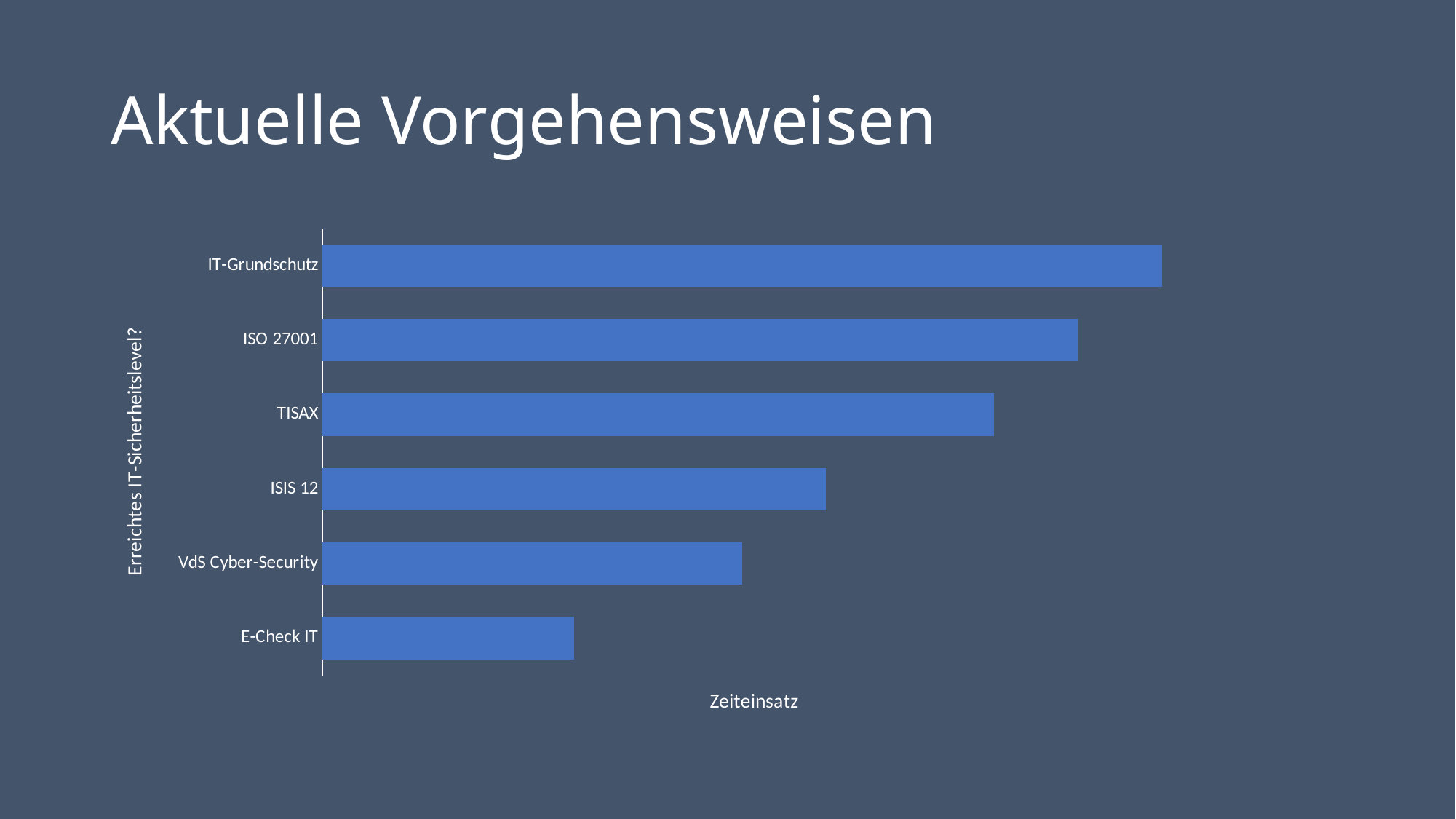
How many categories are plotted in the chart? 6 Which category has the longest bar? IT-Grundschutz Which has the larger value, VdS Cyber-Security or ISIS 12? ISIS 12 Which category is listed second from the top in the chart? ISO 27001 Which has the larger value, ISO 27001 or TISAX? ISO 27001 Which category has the shortest bar? E-Check IT Which has the larger value, E-Check IT or TISAX? TISAX What is the label of the vertical axis? Erreichtes IT-Sicherheitslevel? What kind of chart is shown on the slide? bar chart What is the label of the horizontal axis? Zeiteinsatz Do the bar lengths increase or decrease going from the top category to the bottom category? decrease